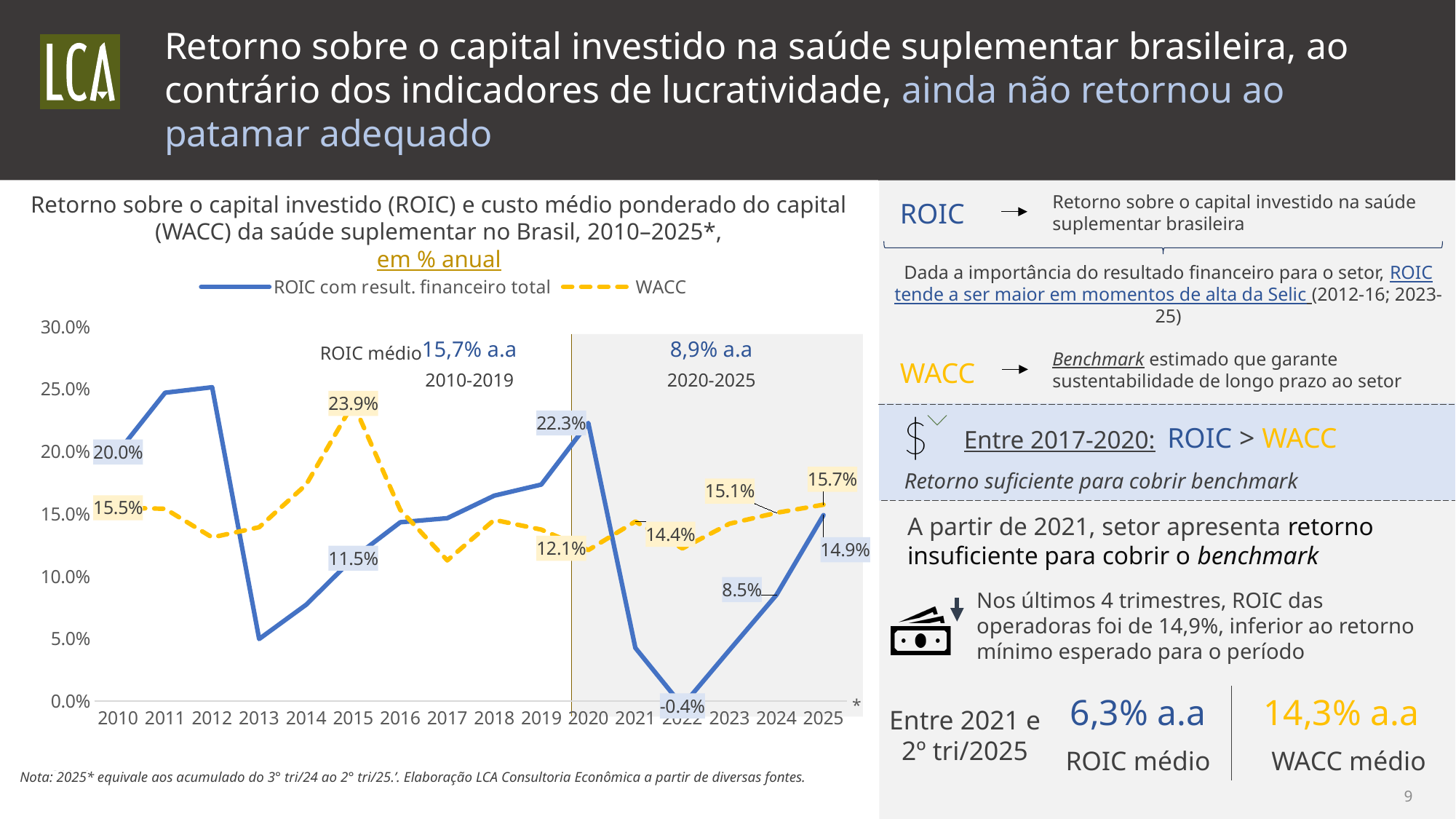
How many series does the chart legend list? 2 What is the difference between WACC and ROIC com result. financeiro total in 2025? 0.8 percentage points What is the WACC value in 2015? 23.9% What kind of chart is shown on the slide? line chart What is the WACC value in 2025? 15.7% In which year does WACC reach its highest value? 2015 Is the value of ROIC com result. financeiro total in 2013 greater or less than 10.0%? less In 2020, which is larger: ROIC com result. financeiro total or WACC? ROIC com result. financeiro total What is the value of ROIC com result. financeiro total in 2022? -0.4% In which year is ROIC com result. financeiro total at its lowest? 2022 What is the value of ROIC com result. financeiro total in 2010? 20.0% How many years are plotted along the x axis of the chart? 16